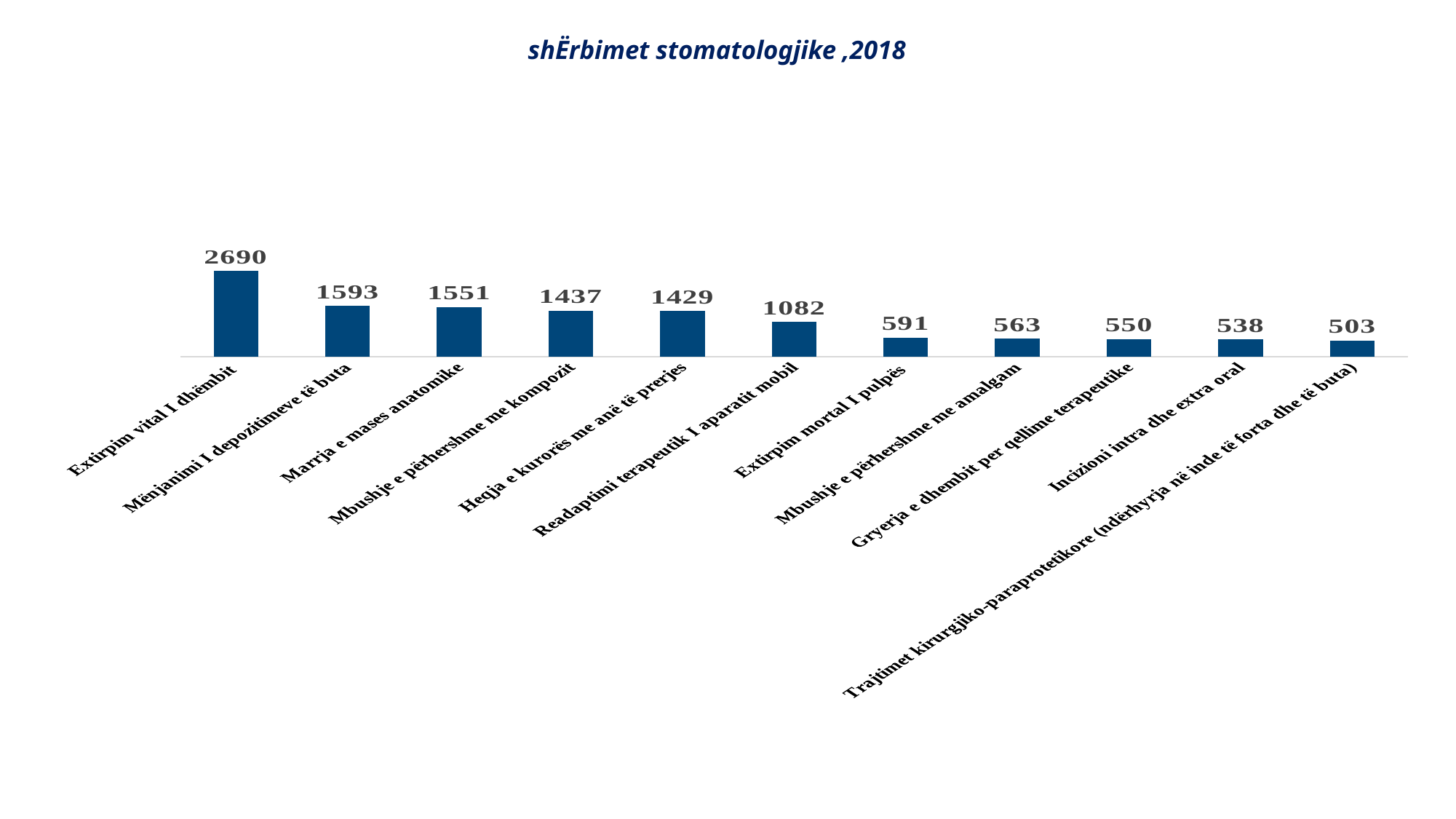
What is the value for Mbushje e përhershme me kompozit? 1437 Which category has the highest value? Extirpim vital I dhëmbit What is the difference between the values for Extirpim vital I dhëmbit and Mënjanimi I depozitimeve të buta? 1097 Which is larger, the value for Marrja e mases anatomike or the value for Heqja e kurorës me anë të prerjes? Marrja e mases anatomike What is the difference between the values for Extirpim mortal I pulpës and Mbushje e përhershme me amalgam? 28 Which category has the lowest value? Trajtimet kirurgjiko-paraprotetikore (ndërhyrja në inde të forta dhe të buta) How many categories are shown in the chart? 11 What is the value for Incizioni intra dhe extra oral? 538 What is the value for Extirpim vital I dhëmbit? 2690 What is the title of the chart? shËrbimet stomatologjike ,2018 What is the value for Readaptimi terapeutik I aparatit mobil? 1082 What kind of chart is shown on the slide? Bar chart